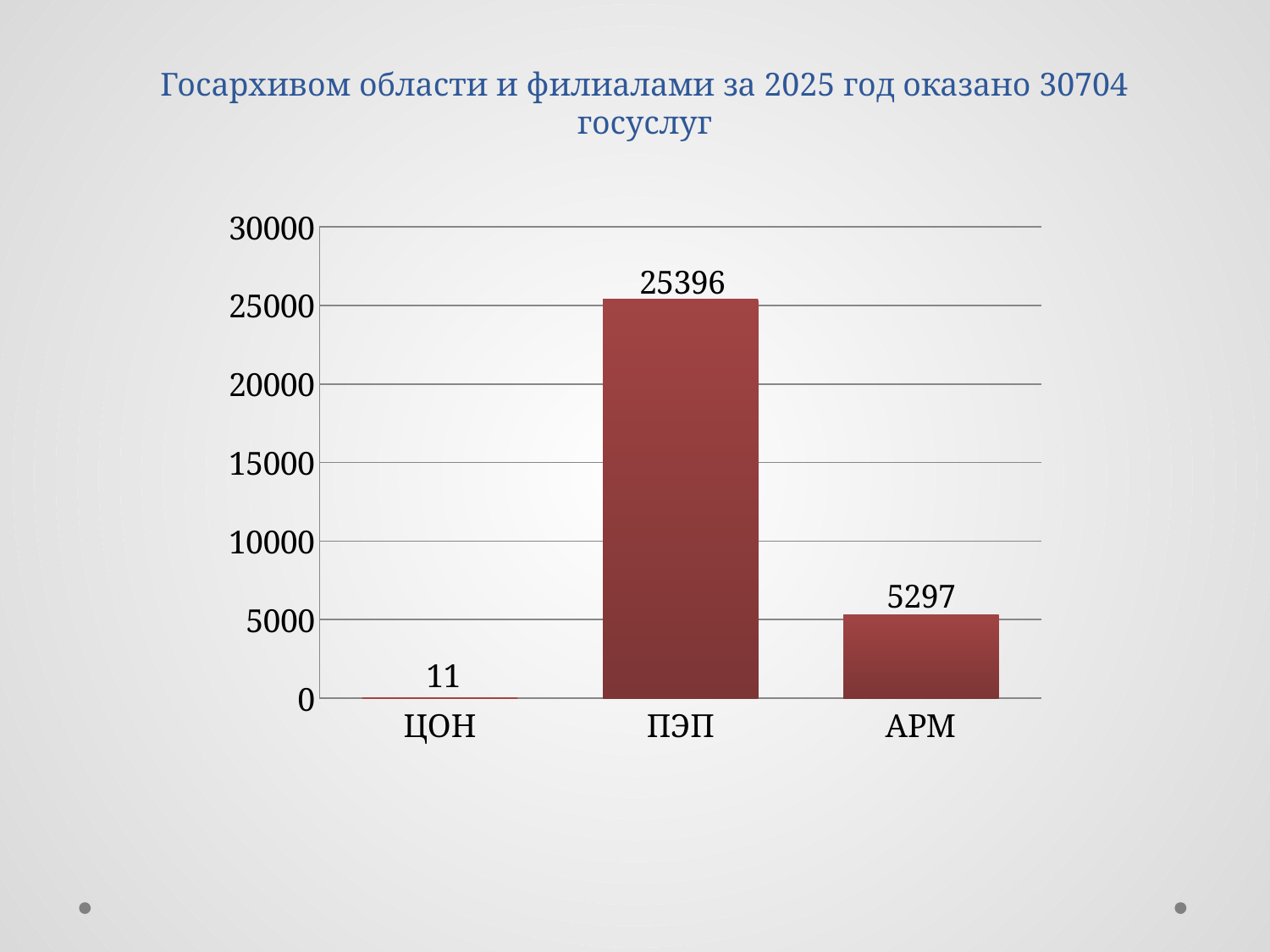
Is the value for ПЭП greater or less than 20000? greater Is the value for АРМ greater or less than 10000? less Which is larger, the value for АРМ or the value for ЦОН? АРМ Which category has the highest value? ПЭП What is the difference between the values for ПЭП and АРМ? 20099 What kind of chart is shown on the slide? bar chart Which category has the lowest value? ЦОН What is the difference between the values for АРМ and ЦОН? 5286 What is the value for АРМ? 5297 How many categories are shown on the x axis? 3 What is the value for ЦОН? 11 What is the value for ПЭП? 25396